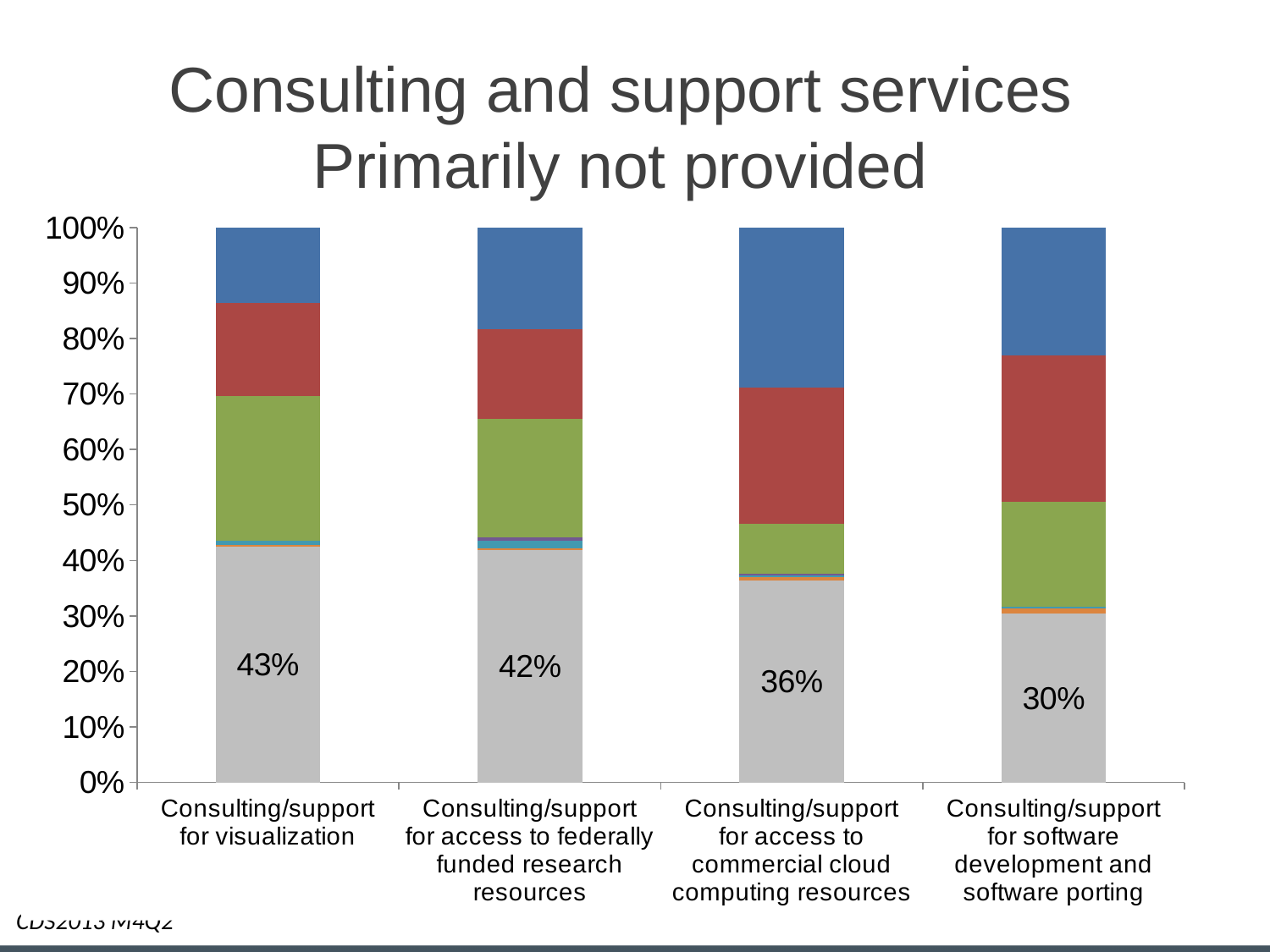
Which has a larger labeled gray-segment value: Consulting/support for access to federally funded research resources or Consulting/support for access to commercial cloud computing resources? Consulting/support for access to federally funded research resources What is the labeled value of the gray segment for Consulting/support for access to commercial cloud computing resources? 36% What is the labeled value of the gray segment for Consulting/support for visualization? 43% Which category has the highest labeled gray-segment value? Consulting/support for visualization What is the title of the chart on the slide? Consulting and support services Primarily not provided Which category has the lowest labeled gray-segment value? Consulting/support for software development and software porting What is the difference between the labeled gray-segment values for Consulting/support for visualization and Consulting/support for software development and software porting? 13 percentage points How many categories are shown along the x axis? 4 What kind of chart is shown on the slide? Stacked bar chart What is the labeled value of the gray segment for Consulting/support for software development and software porting? 30% Do the labeled gray-segment values rise or fall from left to right across the categories? Fall What is the labeled value of the gray segment for Consulting/support for access to federally funded research resources? 42%